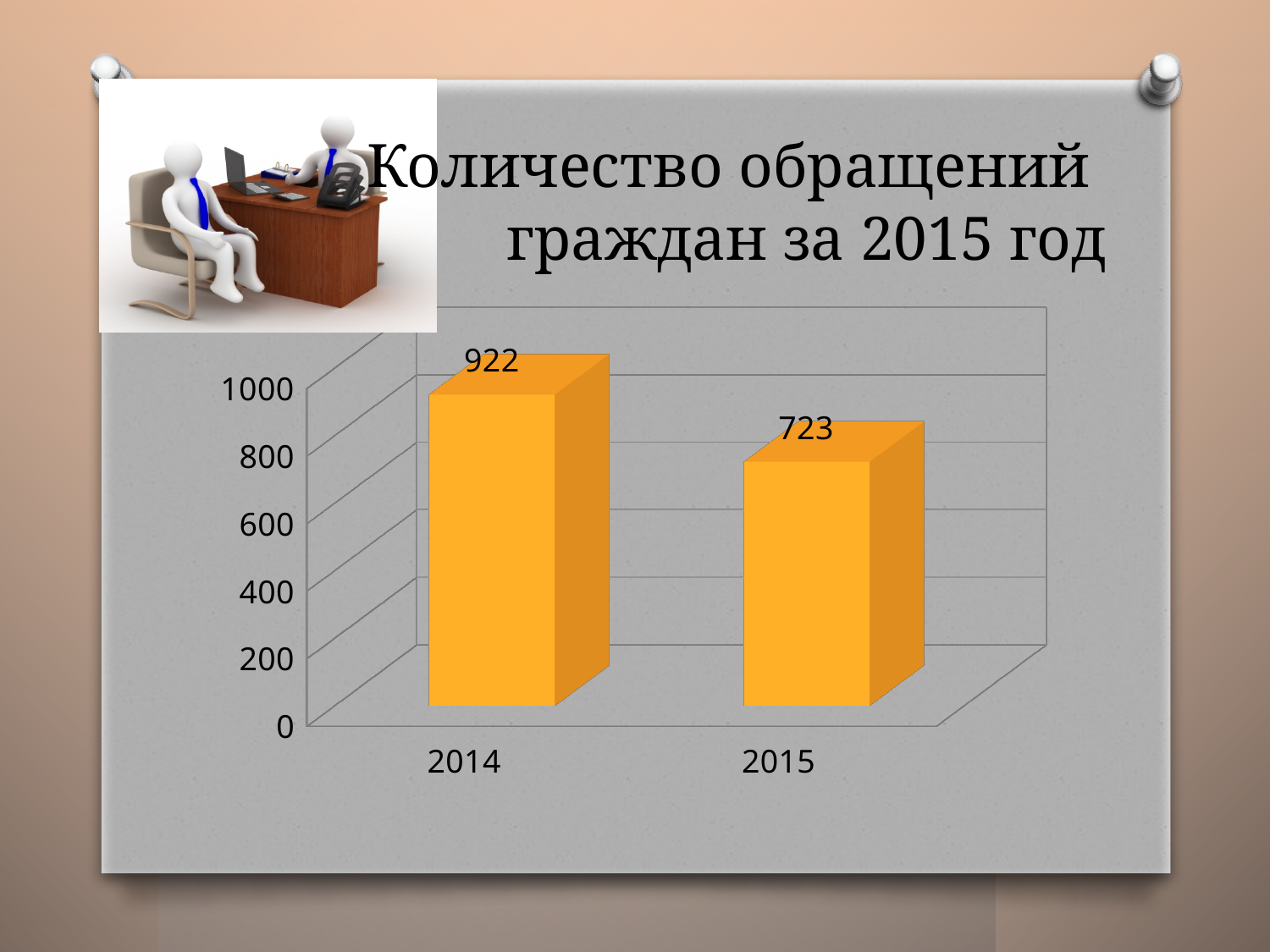
How many categories are shown on the x axis? 2 What is the value for 2015? 723 Which year has the highest value? 2014 What is the difference between the values for 2014 and 2015? 199 What kind of chart is shown on the slide? bar chart Which is larger, the value for 2014 or the value for 2015? 2014 Which year has the lowest value? 2015 Do the values rise or fall from 2014 to 2015? fall What is the value for 2014? 922 Is the value for 2014 greater or less than 800? greater Is the value for 2015 greater or less than 800? less What is the title of the slide? Количество обращений граждан за 2015 год